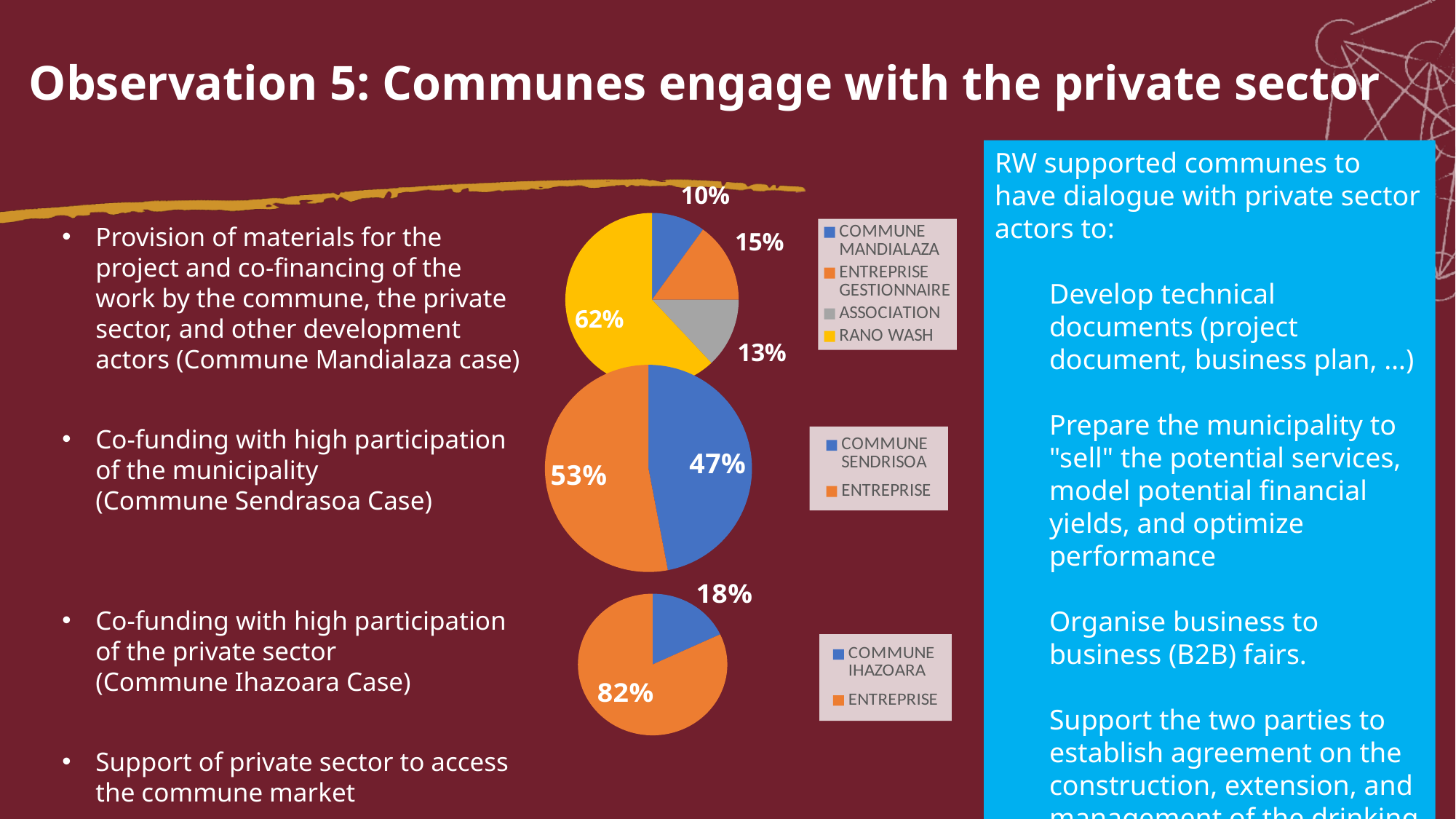
In the top pie chart, how many categories does the legend list? 4 In the middle pie chart, which is larger, COMMUNE SENDRISOA or ENTREPRISE? ENTREPRISE In the top pie chart, what is the difference between the RANO WASH share and the ENTREPRISE GESTIONNAIRE share? 47% In the top pie chart, what share does RANO WASH have? 62% In the top pie chart, which category has the largest share? RANO WASH In the bottom pie chart, what share does COMMUNE IHAZOARA have? 18% In the top pie chart, what share does ASSOCIATION have? 13% In the top pie chart, which category has the smallest share? COMMUNE MANDIALAZA In the bottom pie chart, what share does ENTREPRISE have? 82% In the middle pie chart, what share does COMMUNE SENDRISOA have? 47% What type of chart is the middle chart on the slide? Pie chart In the bottom pie chart, what is the difference between the ENTREPRISE share and the COMMUNE IHAZOARA share? 64%